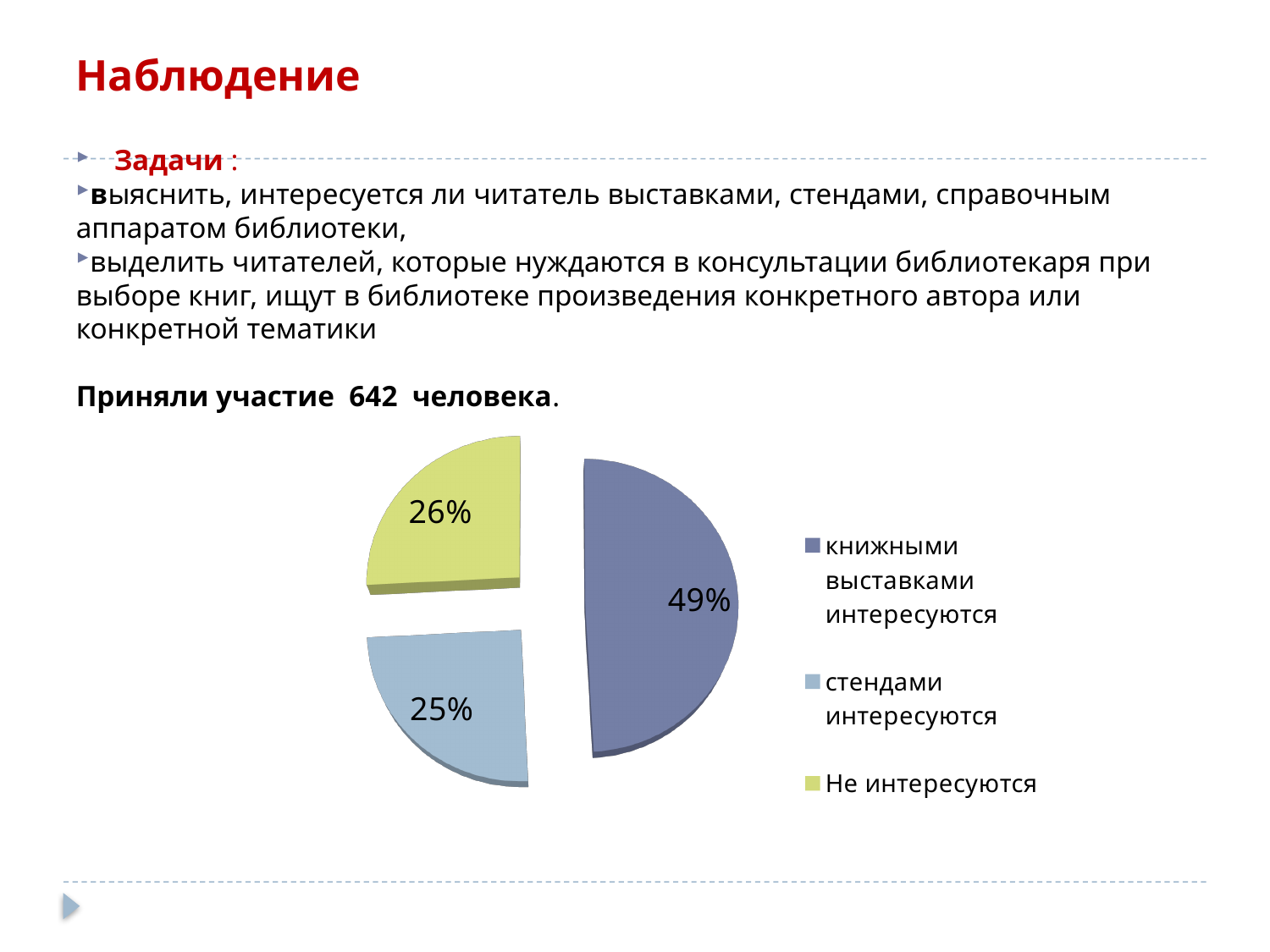
What colour is the slice for "Не интересуются"? yellow-green What share of the pie is labelled "книжными выставками интересуются"? 49% What share of the pie is labelled "стендами интересуются"? 25% Which category has the largest slice of the pie? книжными выставками интересуются What is the difference in percentage points between "Не интересуются" and "стендами интересуются"? 1 How many slices does the pie chart have? 3 Which is larger: the slice for "книжными выставками интересуются" or the slice for "Не интересуются"? книжными выставками интересуются Which category has the smallest slice of the pie? стендами интересуются What is the difference in percentage points between "книжными выставками интересуются" and "Не интересуются"? 23 What kind of chart is shown on the slide? pie chart What share of the pie is labelled "Не интересуются"? 26% How many entries does the legend list? 3